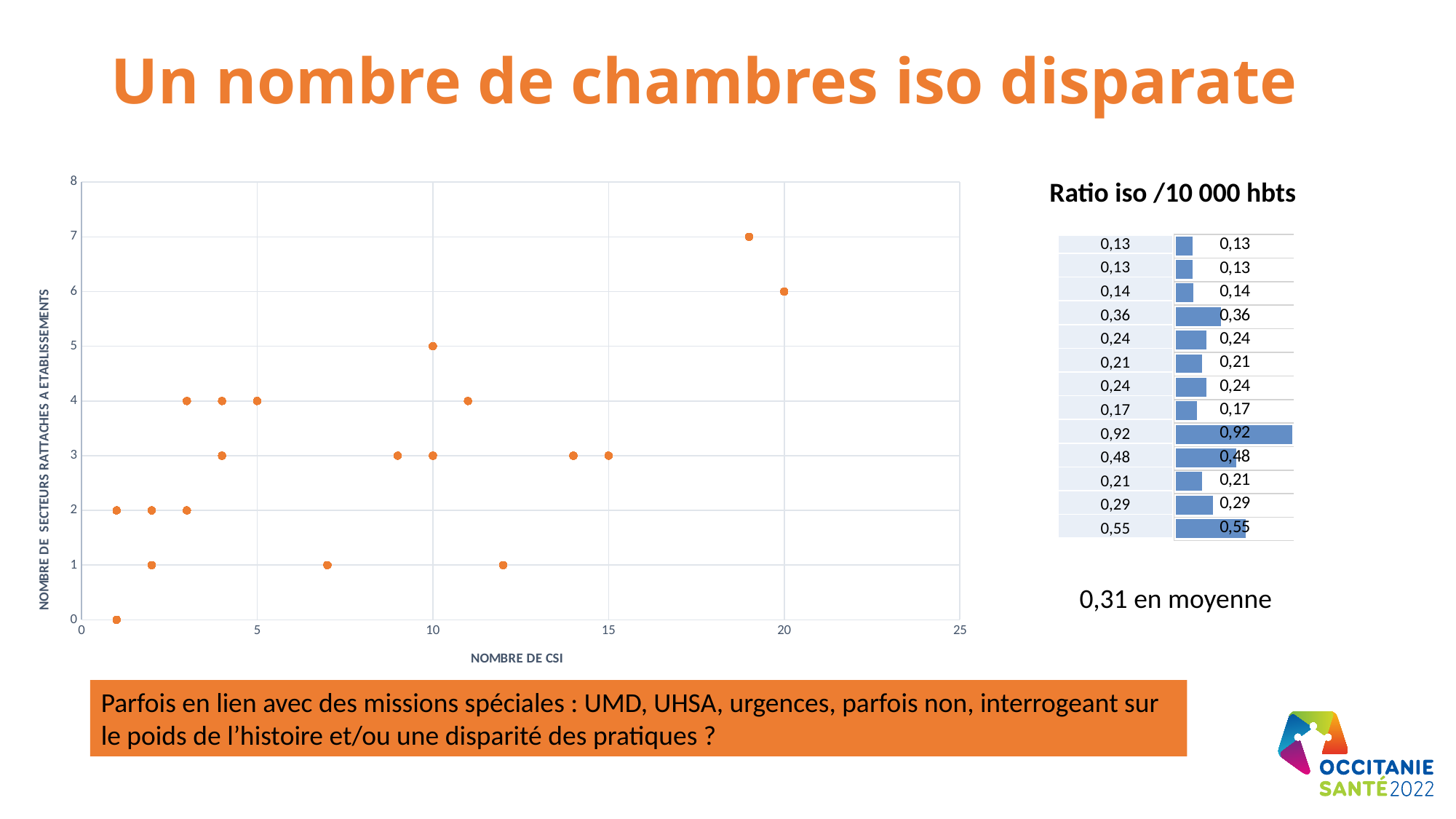
In the scatter chart on the left, is the vertical value of the point at 20 CSI greater or less than 5? greater In the 'Ratio iso /10 000 hbts' chart, what is the lowest value? 0,13 What is the title of the horizontal axis of the scatter chart on the left? NOMBRE DE CSI In the scatter chart on the left, what is the highest value on the vertical axis reached by any point? 7 What kind of chart is the small chart on the right under 'Ratio iso /10 000 hbts'? bar chart In the 'Ratio iso /10 000 hbts' chart, which is larger: the value 0,48 or the value 0,36? 0,48 In the 'Ratio iso /10 000 hbts' chart, how many bars are shown? 13 In the 'Ratio iso /10 000 hbts' chart, what is the difference between the highest value (0,92) and the last value (0,55)? 0,37 In the scatter chart on the left, how many data points are plotted? 19 What kind of chart is the large chart on the left of the slide? scatter chart In the 'Ratio iso /10 000 hbts' chart, what is the highest value? 0,92